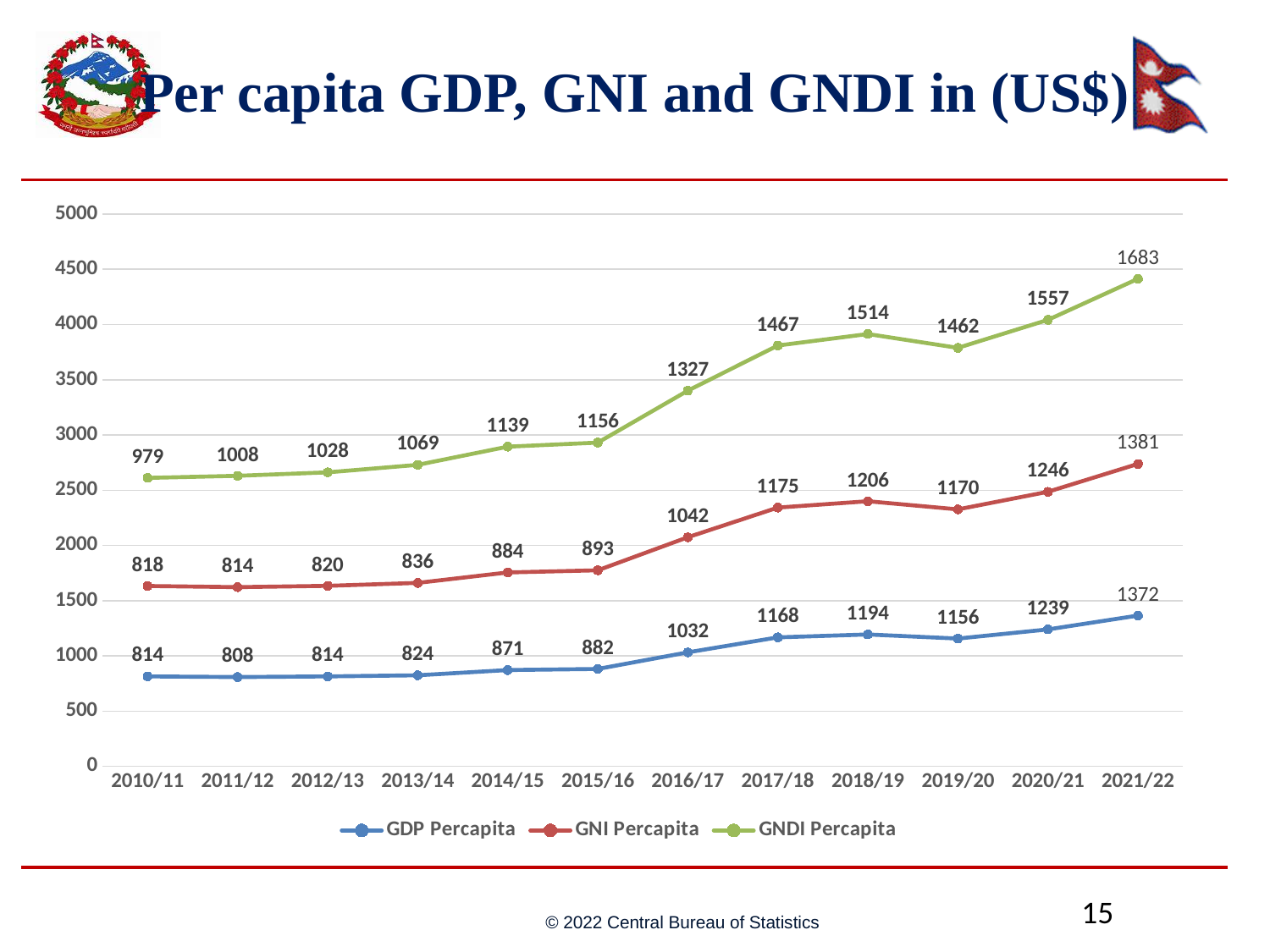
What is the GDP Percapita value for 2016/17? 1032 By how much did GDP Percapita increase from 2020/21 to 2021/22? 133 What is the GNI Percapita value for 2013/14? 836 In which year is GDP Percapita lowest? 2011/12 How many years are shown on the x axis? 12 Which year has the larger GNI Percapita, 2018/19 or 2019/20? 2018/19 What is the difference between GNDI Percapita and GNI Percapita in 2021/22? 302 How many series does the legend list? 3 What kind of chart is shown on the slide? line chart In which year is GNDI Percapita highest? 2021/22 What is the GNDI Percapita value for 2021/22? 1683 Does GDP Percapita rise or fall from 2015/16 to 2018/19? rise